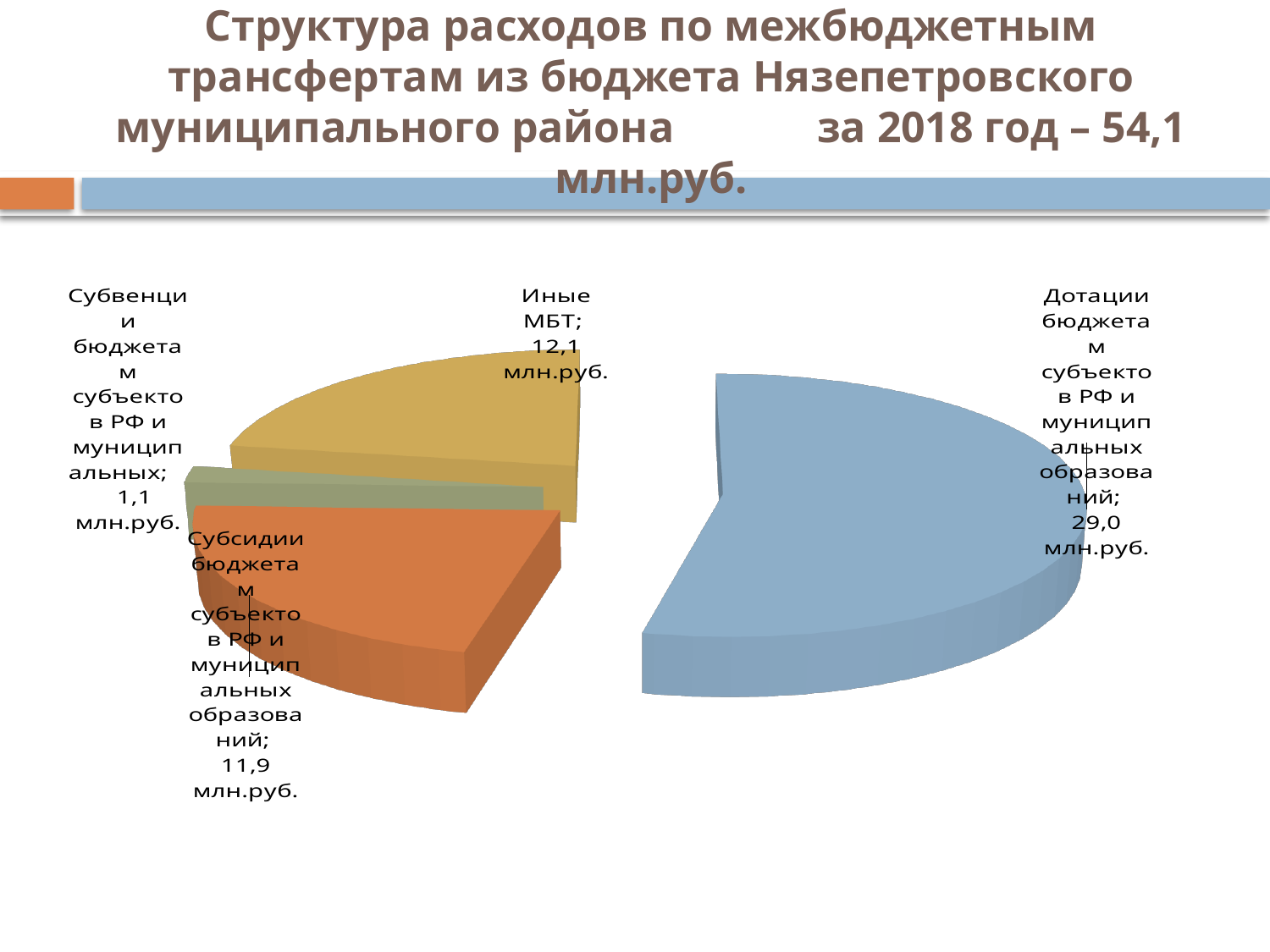
What is the total of all slices in the pie chart, as stated in the slide title? 54,1 млн.руб. What is the difference between the 'Дотации' slice and the 'Иные МБТ' slice? 16,9 млн.руб. What value is shown for the slice 'Иные МБТ'? 12,1 млн.руб. What value is shown for the slice 'Субсидии бюджетам субъектов РФ и муниципальных образований'? 11,9 млн.руб. What is the difference between the 'Иные МБТ' slice and the 'Субсидии' slice? 0,2 млн.руб. How many slices does the pie chart have? 4 Which slice of the pie chart has the largest value? Дотации бюджетам субъектов РФ и муниципальных образований What value is shown for the slice 'Дотации бюджетам субъектов РФ и муниципальных образований'? 29,0 млн.руб. Which slice of the pie chart has the smallest value? Субвенции бюджетам субъектов РФ и муниципальных Which is larger: the 'Дотации' slice or the 'Субсидии' slice? Дотации What kind of chart is shown on the slide? Pie chart What value is shown for the slice 'Субвенции бюджетам субъектов РФ и муниципальных'? 1,1 млн.руб.